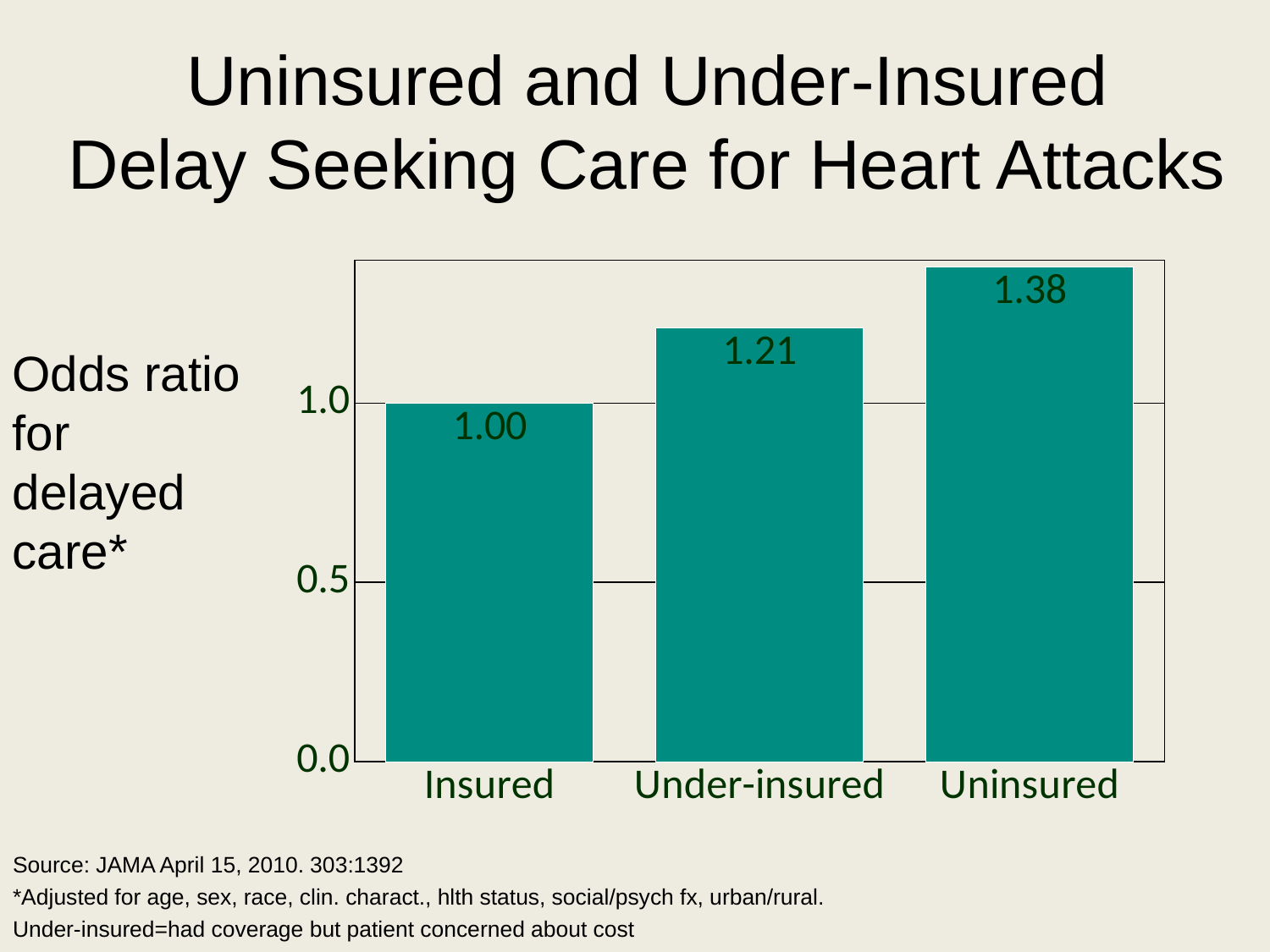
What kind of chart is shown on the slide? bar chart What is the odds ratio for delayed care for the Uninsured group? 1.38 What is the difference between the odds ratios for the Uninsured and Under-insured groups? 0.17 How many groups are shown on the chart? 3 What is the difference between the odds ratios for the Uninsured and Insured groups? 0.38 Do the odds ratios rise or fall from Insured to Uninsured along the x axis? rise Which group has the highest odds ratio for delayed care? Uninsured What is the odds ratio for delayed care for the Under-insured group? 1.21 What is the odds ratio for delayed care for the Insured group? 1.00 Which group has the lowest odds ratio for delayed care? Insured Is the odds ratio for the Under-insured group greater or less than 1.0? greater Which group has a larger odds ratio, Under-insured or Insured? Under-insured